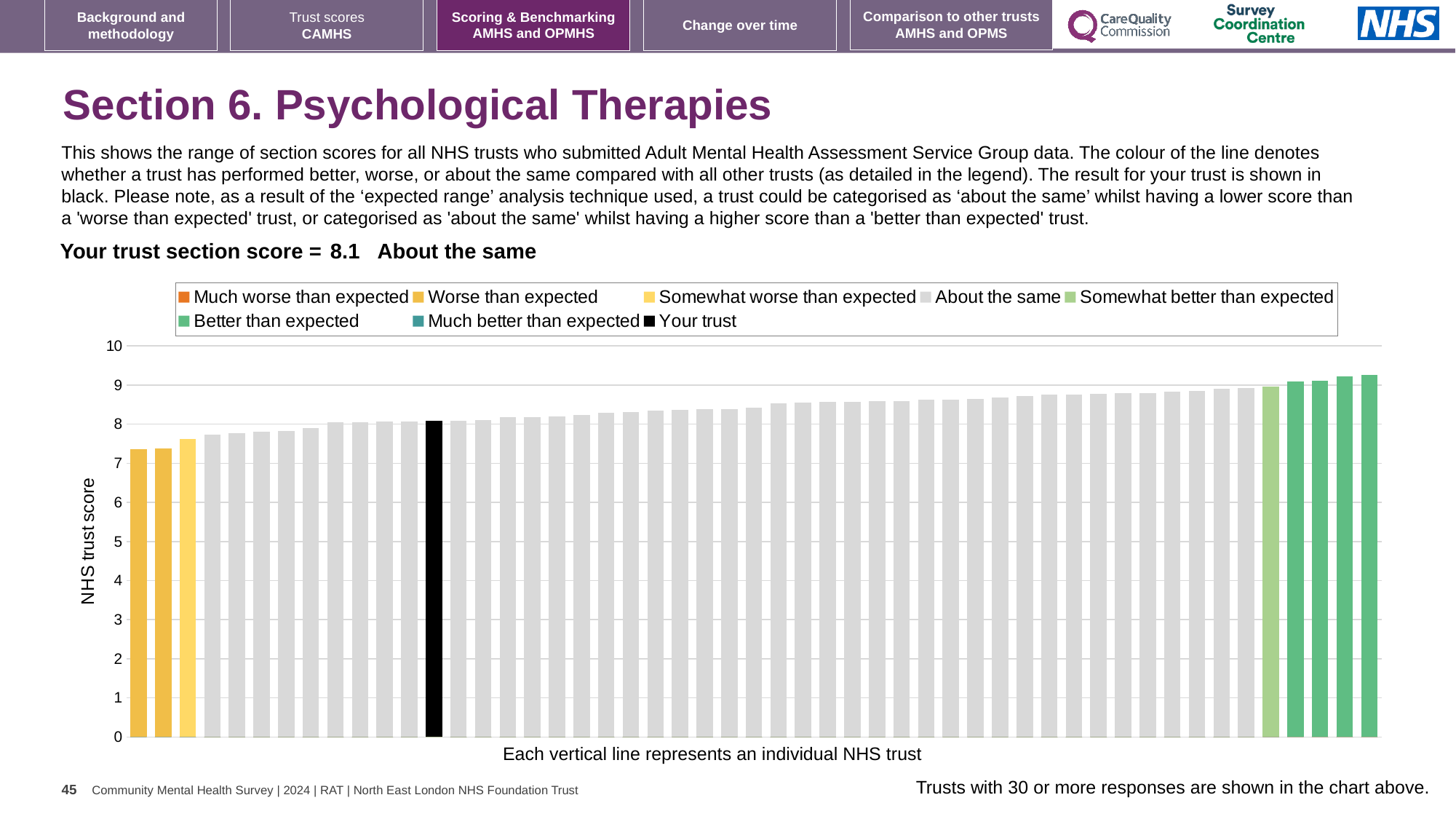
What colour is the bar representing your trust? black How many entries does the chart legend list? 8 Is the value of the tallest bar in the chart greater or less than 10? less Do the bar values rise or fall from left to right along the x axis? rise Is the value of the black 'Your trust' bar greater or less than 9? less What kind of chart is shown on the slide? bar chart How many bars in the chart are coloured yellow/orange (worse than expected categories)? 3 Is the value of the shortest bar in the chart greater or less than 7? greater Which performance category is your trust placed in for this section? About the same What is the section score for your trust shown on the slide? 8.1 What is the label on the vertical axis of the chart? NHS trust score